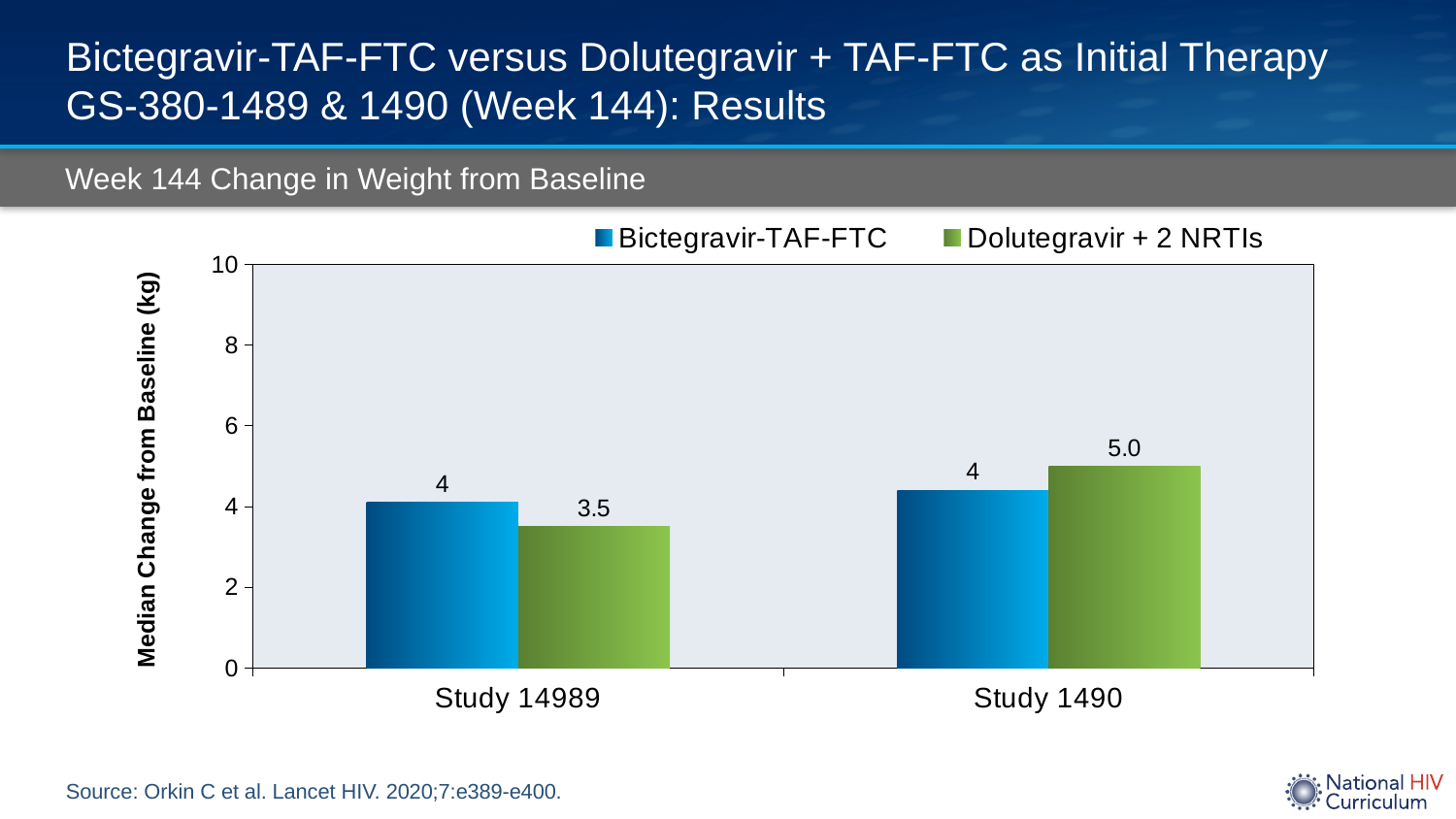
What kind of chart is shown on the slide? Bar chart What is the median change in weight from baseline for Dolutegravir + 2 NRTIs in Study 1490? 5.0 How many series does the legend list? 2 What is the median change in weight from baseline for Bictegravir-TAF-FTC in Study 1490? 4 What is the median change in weight from baseline for Dolutegravir + 2 NRTIs in Study 14989? 3.5 In Study 1490, what is the difference in median weight change between Dolutegravir + 2 NRTIs and Bictegravir-TAF-FTC? 1.0 kg How many studies are shown on the x axis of the chart? 2 Is the value for Dolutegravir + 2 NRTIs in Study 1490 greater or less than 4? greater What is the median change in weight from baseline for Bictegravir-TAF-FTC in Study 14989? 4 In Study 14989, which treatment has the larger median change in weight from baseline? Bictegravir-TAF-FTC Which bar shows the highest median change in weight from baseline? Dolutegravir + 2 NRTIs in Study 1490 Which bar shows the lowest median change in weight from baseline? Dolutegravir + 2 NRTIs in Study 14989